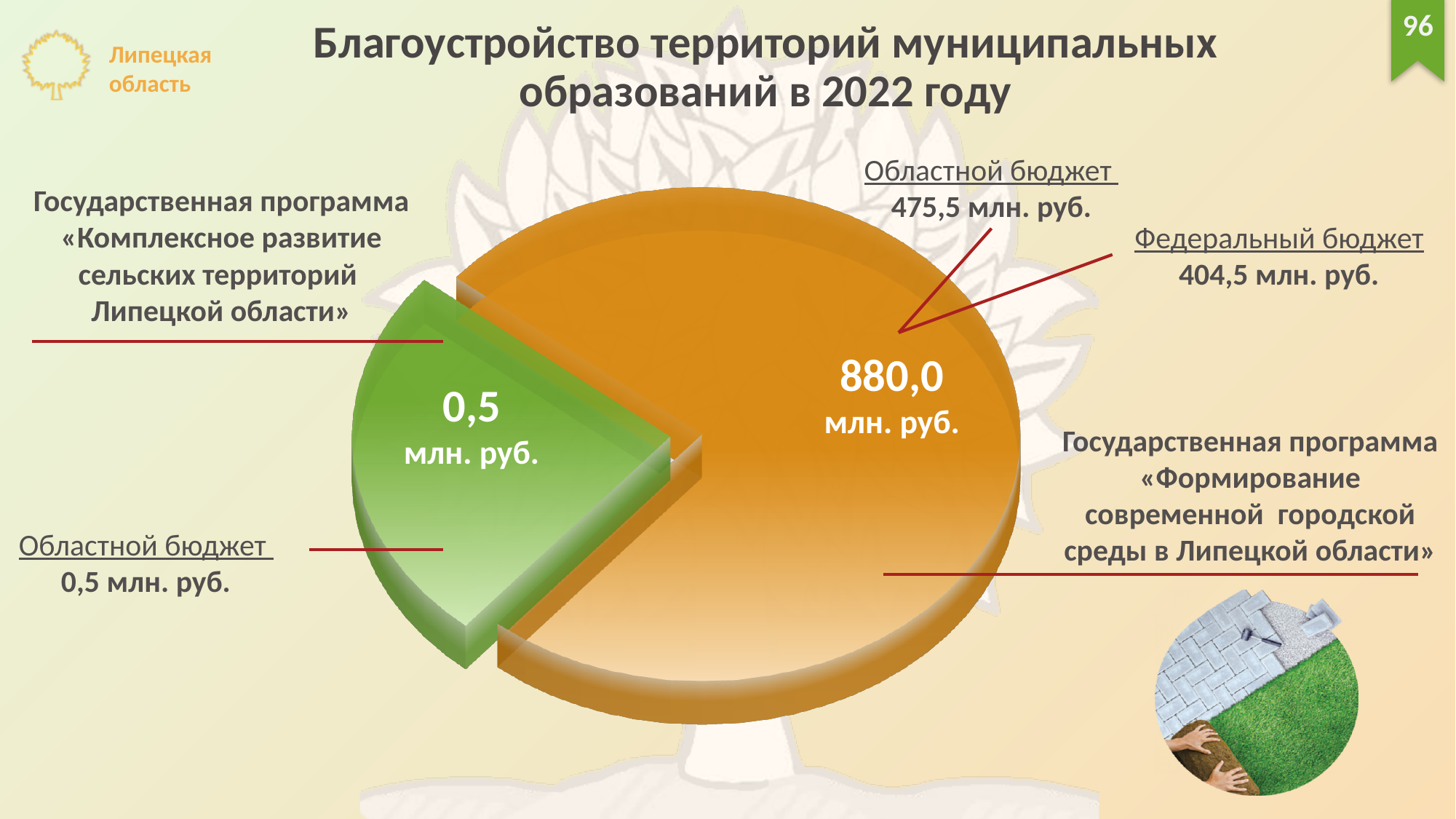
How much of the 880,0 млн. руб. slice comes from the Федеральный бюджет? 404,5 млн. руб. What is the value of the slice for the programme «Комплексное развитие сельских территорий Липецкой области»? 0,5 млн. руб. Which programme has the smallest slice of the pie? «Комплексное развитие сельских территорий Липецкой области» Which programme has the largest slice of the pie? «Формирование современной городской среды в Липецкой области» Within the 880,0 млн. руб. slice, which is larger: the Областной бюджет or the Федеральный бюджет contribution? Областной бюджет What is the total of the two slices of the pie? 880,5 млн. руб. What kind of chart is shown on the slide? pie chart What is the difference between the two slices of the pie, in млн. руб.? 879,5 млн. руб. What colour is the slice for the programme «Комплексное развитие сельских территорий Липецкой области»? green How many slices does the pie chart have? 2 How much of the 880,0 млн. руб. slice comes from the Областной бюджет? 475,5 млн. руб. What is the value of the slice for the programme «Формирование современной городской среды в Липецкой области»? 880,0 млн. руб.